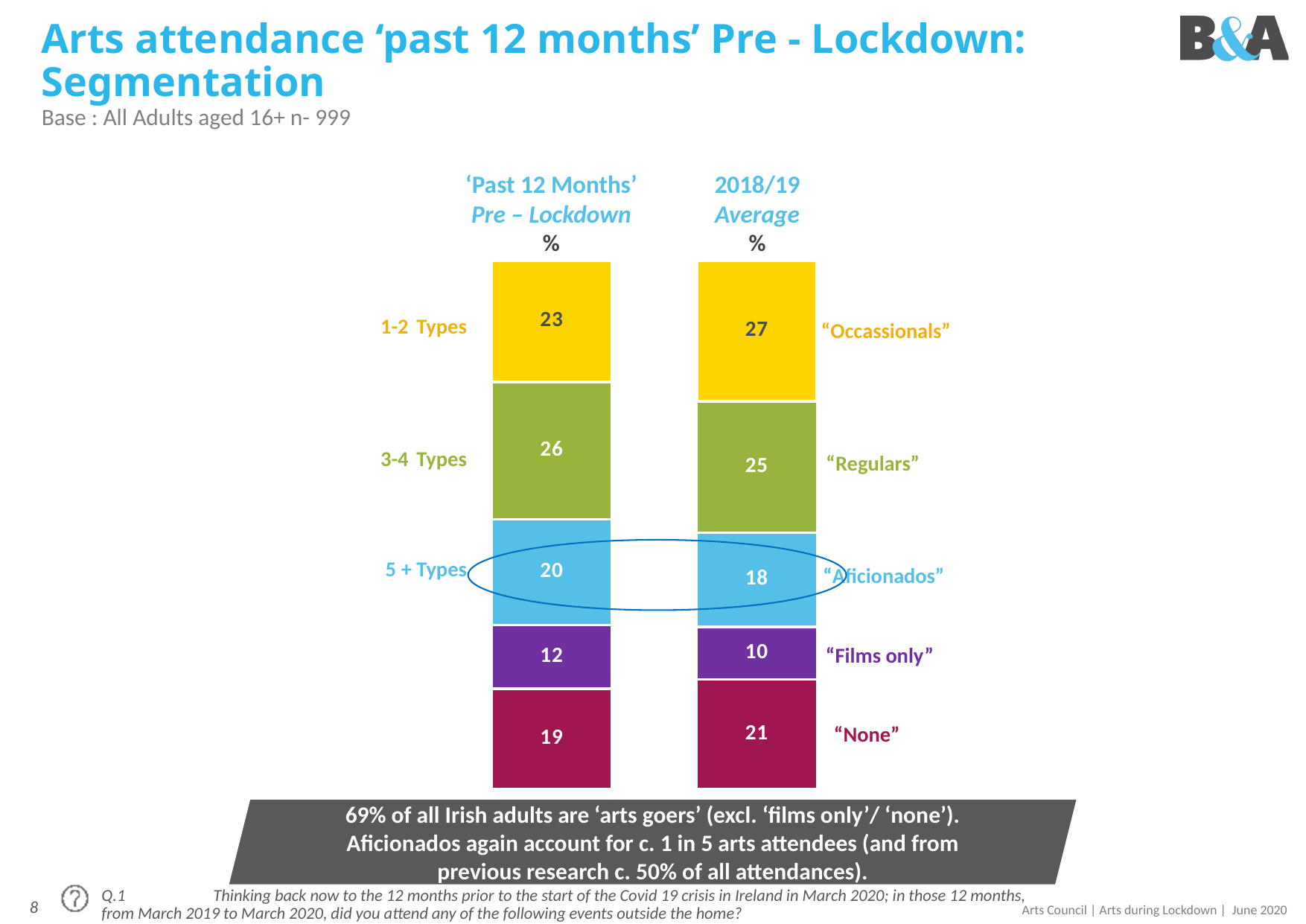
What is the value for "Regulars" (3-4 Types) in the 'Past 12 Months' Pre-Lockdown bar? 26 Which is larger: the "None" value in the 'Past 12 Months' Pre-Lockdown bar or in the 2018/19 Average bar? 2018/19 Average Which segment has the lowest value in the 2018/19 Average bar? "Films only" What is the value for "Occassionals" in the 2018/19 Average bar? 27 Which segment has the highest value in the 'Past 12 Months' Pre-Lockdown bar? "Regulars" (3-4 Types) What is the value for "Films only" in the 'Past 12 Months' Pre-Lockdown bar? 12 What is the total of the 'Past 12 Months' Pre-Lockdown stacked bar? 100 Which segment is circled on the chart? "Aficionados" (5 + Types) What kind of chart is shown on the slide? Stacked bar chart What is the value for "None" in the 2018/19 Average bar? 21 How many segments make up each stacked bar? 5 What is the difference between the "Aficionados" values in the 'Past 12 Months' Pre-Lockdown bar and the 2018/19 Average bar? 2